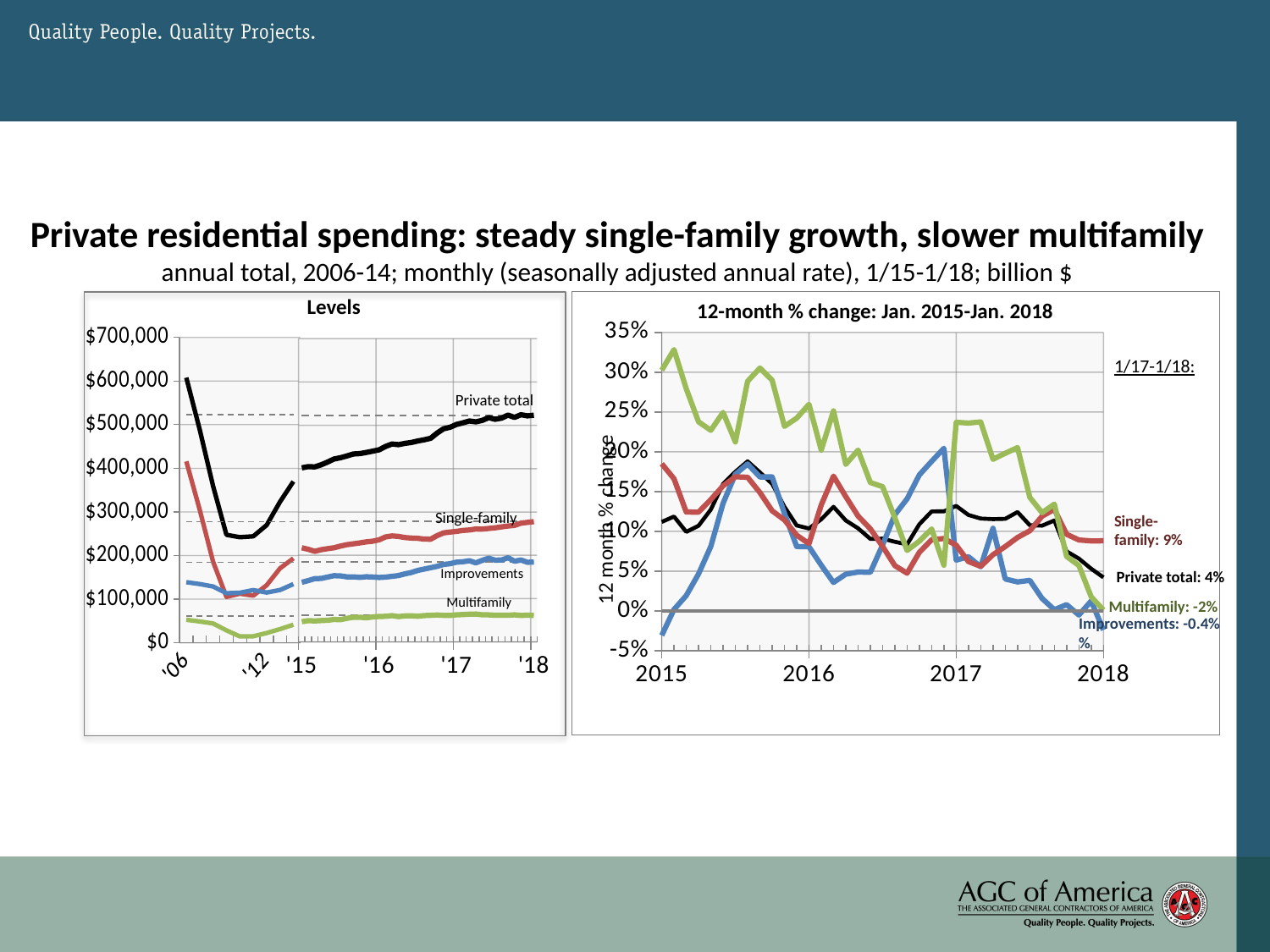
In the 'Levels' chart on the left, is the private total value at '18 greater or less than $500,000? greater In the '12-month % change' chart on the right, what was the 12-month % change for improvements for 1/17-1/18? -0.4% In the '12-month % change' chart on the right, which series had the highest 12-month % change for 1/17-1/18? Single-family In the '12-month % change' chart on the right, what was the 12-month % change for private total for 1/17-1/18? 4% In the '12-month % change' chart on the right, how many percentage points higher was the single-family change than the private total change for 1/17-1/18? 5 percentage points In the '12-month % change' chart on the right, what was the 12-month % change for multifamily for 1/17-1/18? -2% In the 'Levels' chart on the left, which series has the highest value at '18? Private total In the '12-month % change' chart on the right, what was the 12-month % change for single-family for 1/17-1/18? 9% In the '12-month % change' chart on the right, which series had the lowest 12-month % change for 1/17-1/18? Multifamily In the '12-month % change' chart on the right, does the multifamily line generally rise or fall from 2015 to 2018? fall How many series are plotted in the 'Levels' chart on the left? 4 What kind of chart is the 'Levels' chart on the left? line chart